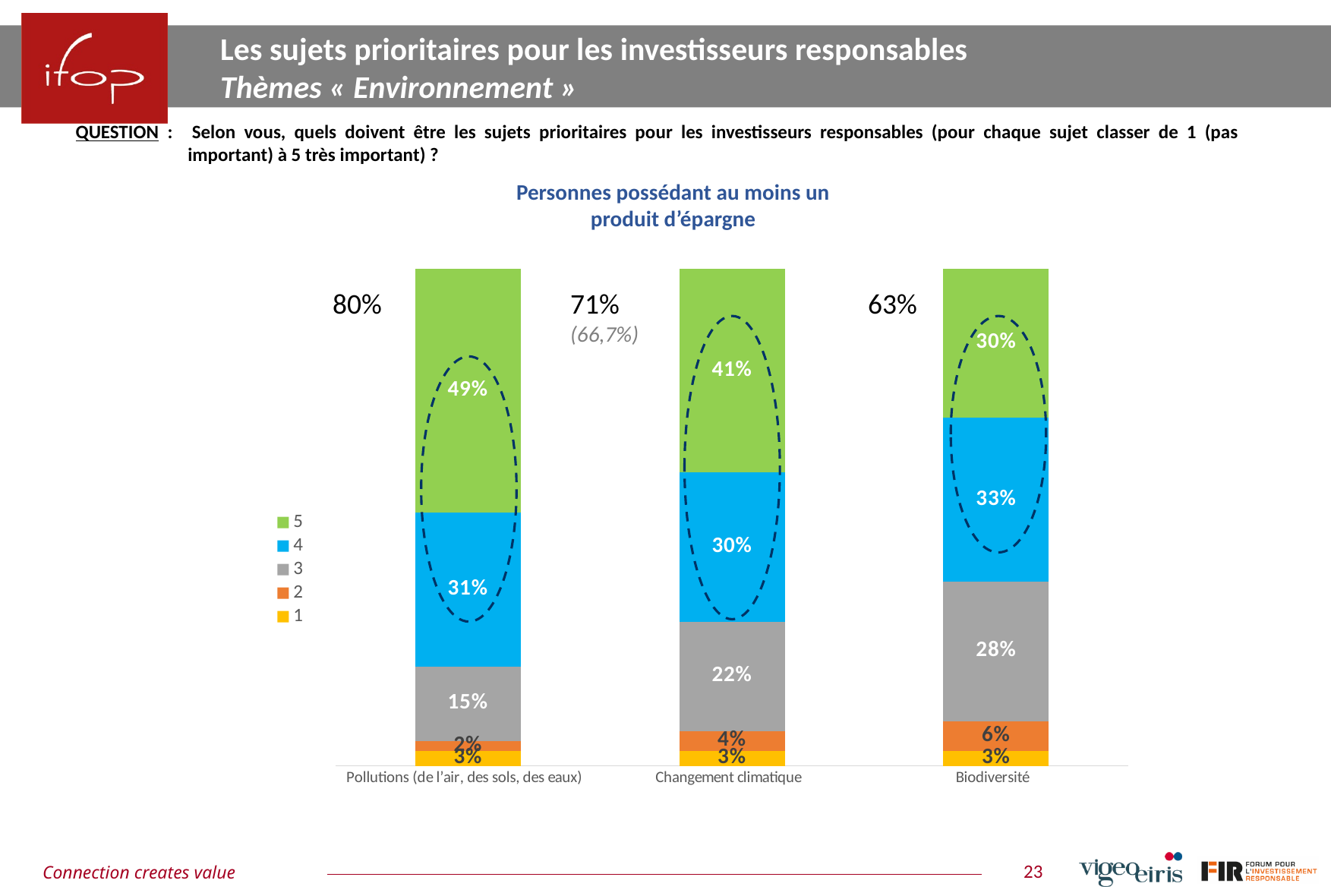
Which category has the highest value for series 5? Pollutions (de l'air, des sols, des eaux) What is the value of series 2 for Biodiversité? 6% How many categories are shown on the x axis? 3 What is the value of series 3 for Biodiversité? 28% What percentage is printed above the Changement climatique bar? 71% Which is larger: series 4 for Biodiversité or series 4 for Pollutions? Biodiversité What is the value of series 5 for Pollutions (de l'air, des sols, des eaux)? 49% What is the difference between the series 5 values for Pollutions and Changement climatique? 8% Which category has the lowest value for series 5? Biodiversité What kind of chart is shown on the slide? Stacked bar chart How many series does the legend list? 5 What is the value of series 4 for Changement climatique? 30%